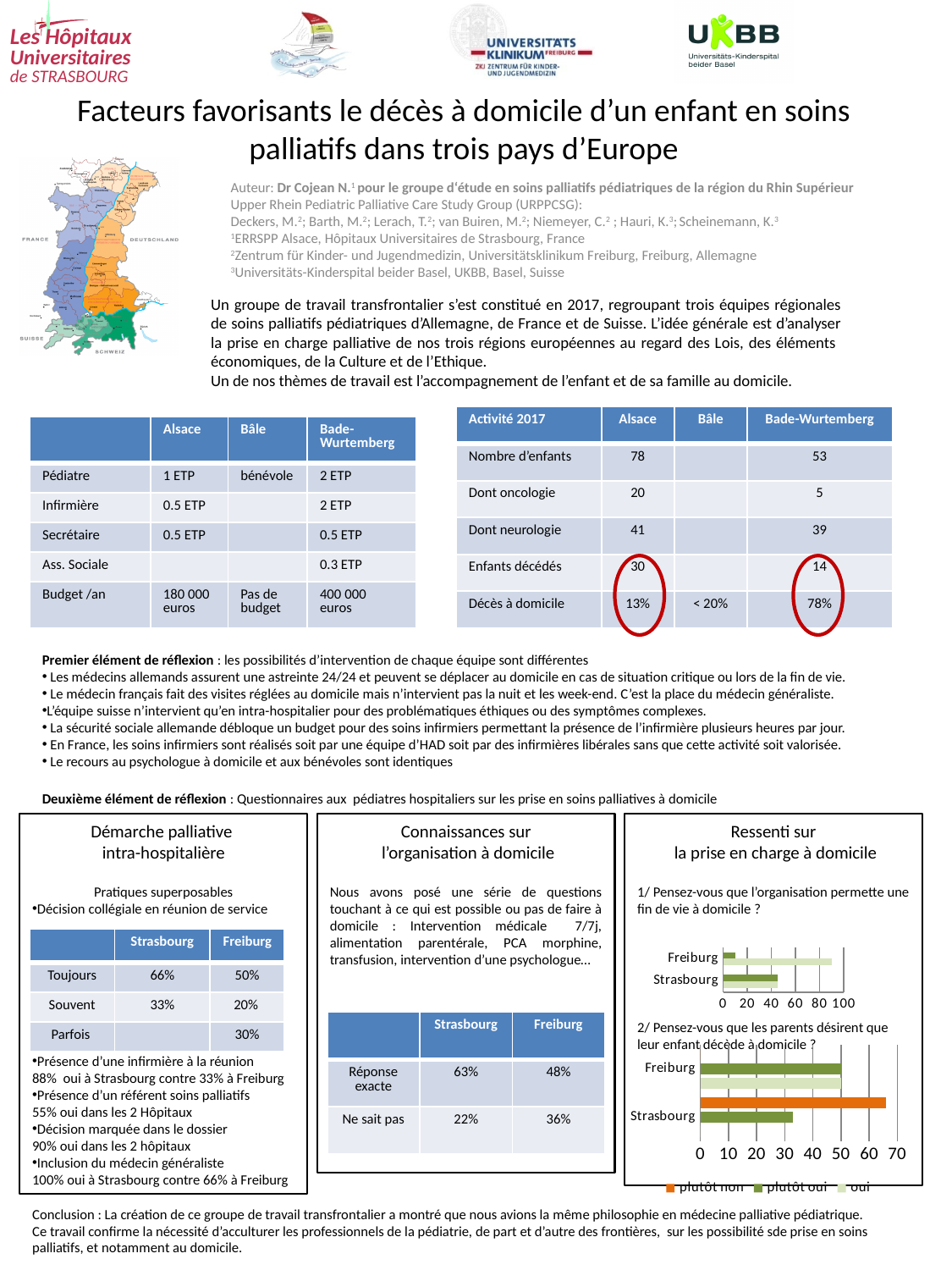
In the chart for question 1 ('Pensez-vous que l'organisation permette une fin de vie à domicile ?'), is the dark green bar for Freiburg greater or less than 20? less In the chart for question 2 ('Pensez-vous que les parents désirent que leur enfant décède à domicile ?'), is the 'plutôt oui' value for Strasbourg greater or less than 40? less In the chart for question 2 ('Pensez-vous que les parents désirent que leur enfant décède à domicile ?'), which is larger for Strasbourg: 'plutôt non' or 'plutôt oui'? plutôt non In the chart for question 2 ('Pensez-vous que les parents désirent que leur enfant décède à domicile ?'), how many series does the legend list? 3 In the chart for question 2 ('Pensez-vous que les parents désirent que leur enfant décède à domicile ?'), what is the highest value shown on the horizontal axis? 70 In the chart for question 1 ('Pensez-vous que l'organisation permette une fin de vie à domicile ?'), is the light green bar for Freiburg greater or less than 60? greater In the chart for question 1 ('Pensez-vous que l'organisation permette une fin de vie à domicile ?'), how many categories are shown on the vertical axis? 2 In the chart for question 1 ('Pensez-vous que l'organisation permette une fin de vie à domicile ?'), which bar for Freiburg is longer: the dark green one or the light green one? the light green one In the chart for question 2 ('Pensez-vous que les parents désirent que leur enfant décède à domicile ?'), how many categories are shown on the vertical axis? 2 In the chart for question 2 ('Pensez-vous que les parents désirent que leur enfant décède à domicile ?'), what kind of chart is used? bar chart In the chart for question 2 ('Pensez-vous que les parents désirent que leur enfant décède à domicile ?'), what are the legend entries? plutôt non, plutôt oui, oui